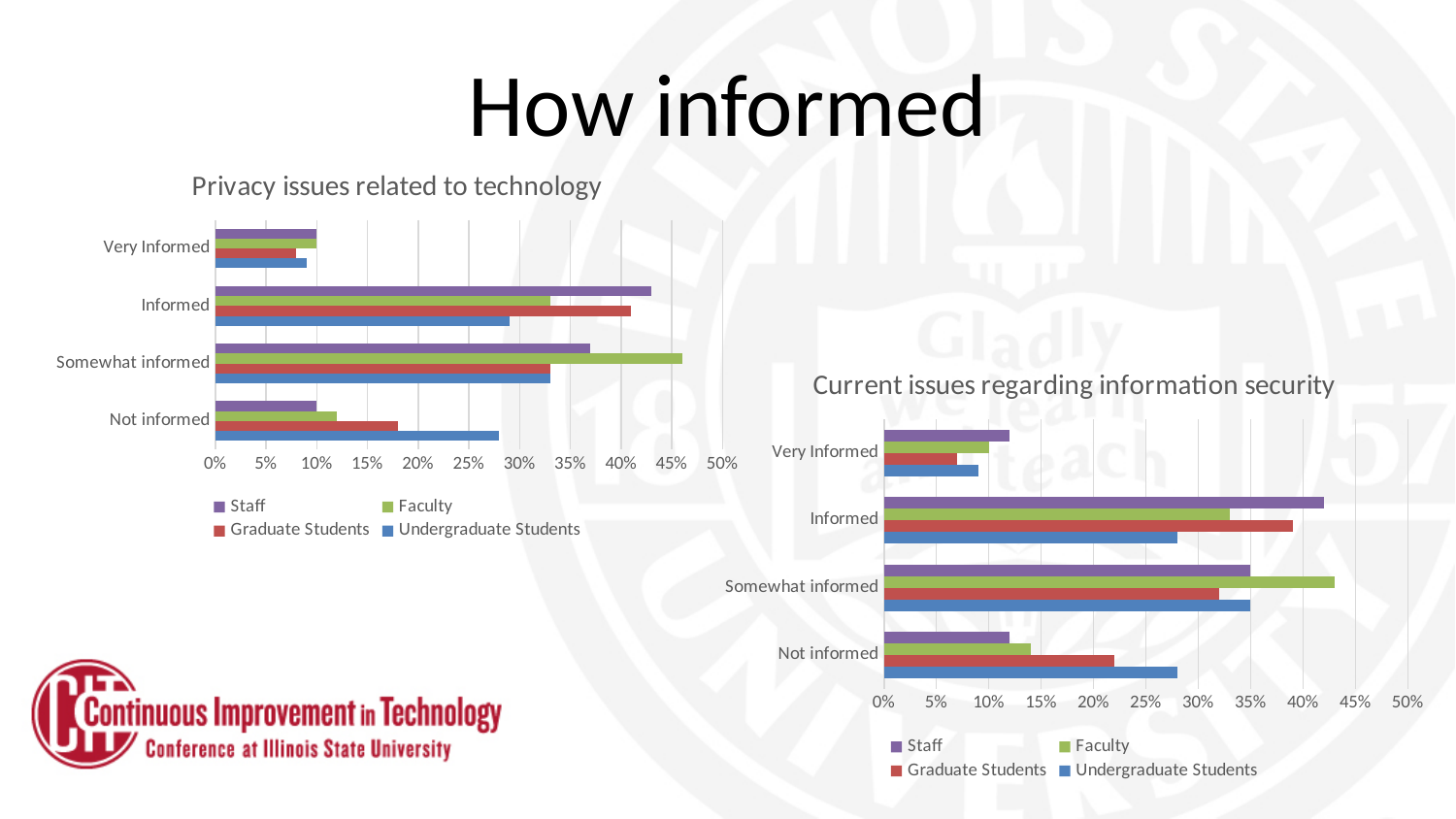
On the 'Privacy issues related to technology' chart, is the Faculty value for Somewhat informed greater or less than 40%? greater On the 'Current issues regarding information security' chart, is the Staff value for Informed greater or less than 40%? greater What kind of chart is the 'Privacy issues related to technology' chart? bar chart How many series does the legend list on the 'Current issues regarding information security' chart? 4 On the 'Privacy issues related to technology' chart, for Informed, which is larger: Staff or Undergraduate Students? Staff On the 'Privacy issues related to technology' chart, which series has the highest value for Not informed? Undergraduate Students On the 'Privacy issues related to technology' chart, is the Undergraduate Students value for Not informed greater or less than 25%? greater On the 'Current issues regarding information security' chart, which series has the highest value for Somewhat informed? Faculty What is the title of the chart on the right side of the slide? Current issues regarding information security On the 'Current issues regarding information security' chart, for Very Informed, which is larger: Staff or Graduate Students? Staff How many categories are shown on the 'Privacy issues related to technology' chart? 4